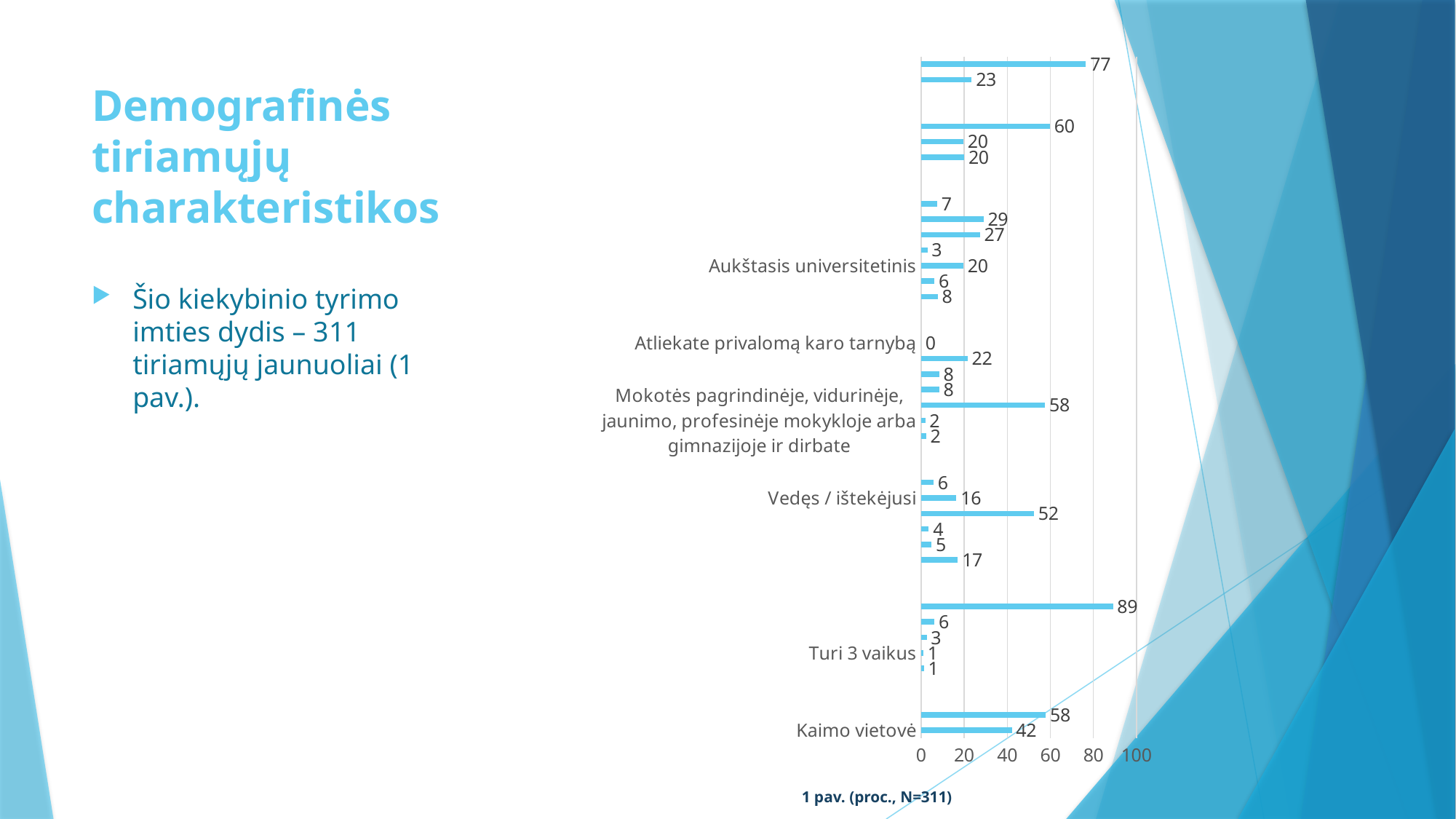
What kind of chart is shown on the slide? bar chart What is the difference between the values for Kaimo vietovė and Turi 3 vaikus? 41 What is the value for Turi 3 vaikus? 1 Which labelled category has the lowest value? Atliekate privalomą karo tarnybą Which is larger, the value for Aukštasis universitetinis or for Vedęs / ištekėjusi? Aukštasis universitetinis What is the value for Aukštasis universitetinis? 20 What is the value for Vedęs / ištekėjusi? 16 What is the largest value shown on the chart? 89 What is the value for Atliekate privalomą karo tarnybą? 0 What is the value for Kaimo vietovė? 42 What is the caption printed below the chart? 1 pav. (proc., N=311) What is the highest tick value on the horizontal axis? 100